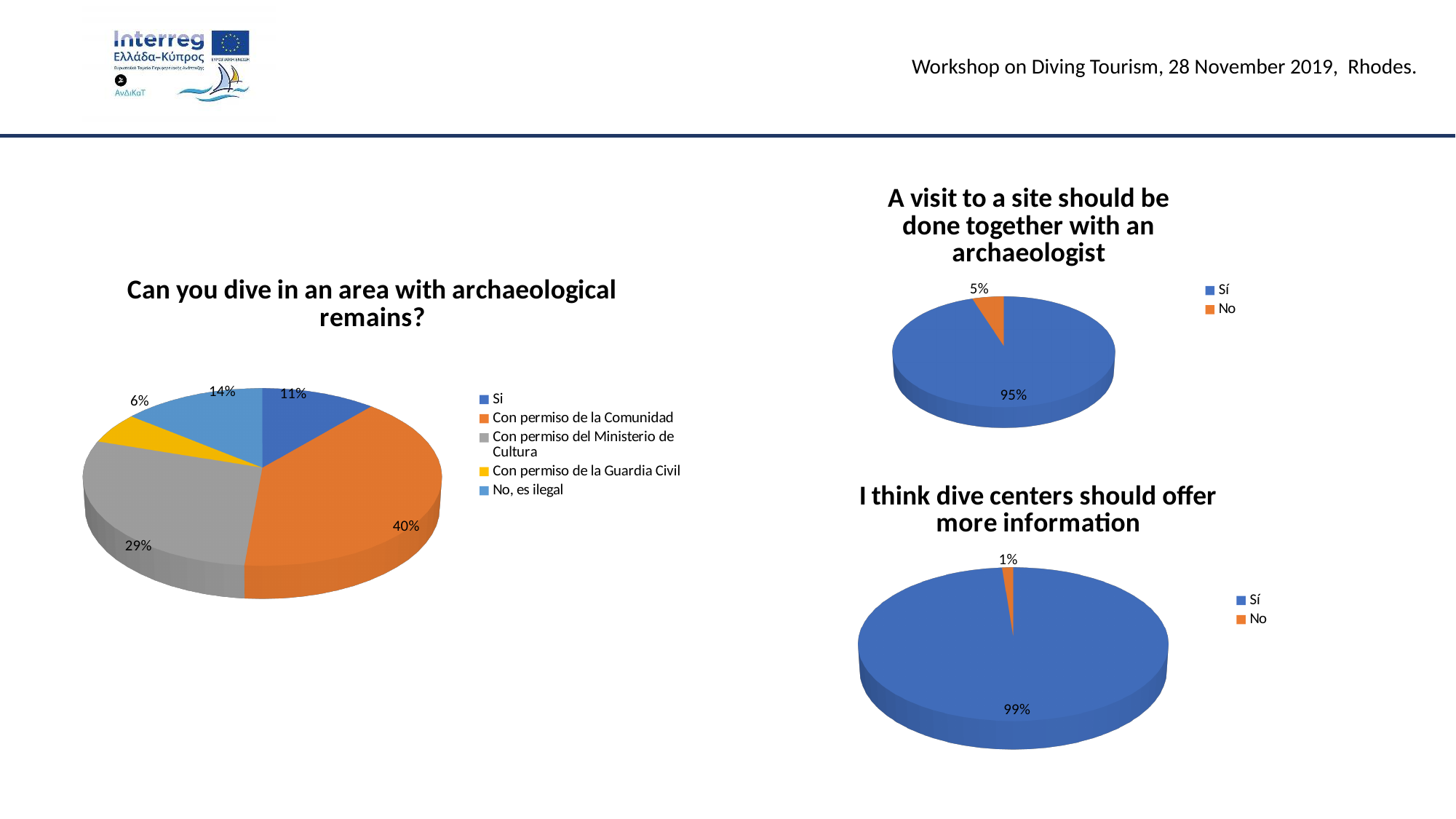
In the chart titled 'Can you dive in an area with archaeological remains?', what share does 'Con permiso del Ministerio de Cultura' have? 29% In the chart titled 'Can you dive in an area with archaeological remains?', what share does 'No, es ilegal' have? 14% In the chart titled 'A visit to a site should be done together with an archaeologist', what share answered 'No'? 5% What type of chart is used for 'I think dive centers should offer more information'? Pie chart In the chart titled 'I think dive centers should offer more information', which answer is larger, 'Sí' or 'No'? Sí In the chart titled 'Can you dive in an area with archaeological remains?', which category has the largest slice? Con permiso de la Comunidad In the chart titled 'Can you dive in an area with archaeological remains?', how many categories does the legend list? 5 In the chart titled 'Can you dive in an area with archaeological remains?', which category has the smallest slice? Con permiso de la Guardia Civil In the chart titled 'Can you dive in an area with archaeological remains?', what is the difference between the 'Con permiso de la Comunidad' and 'Si' shares? 29%